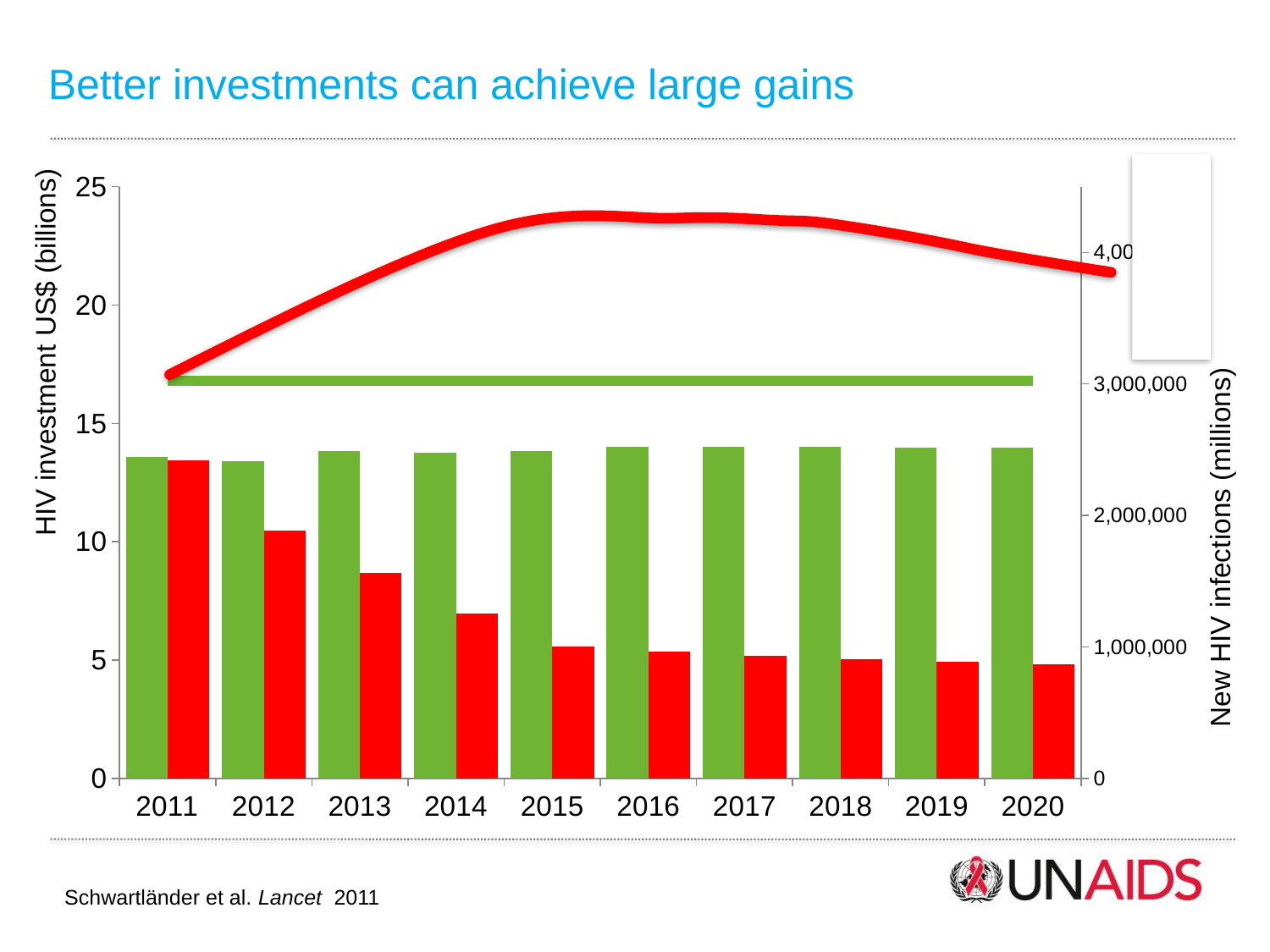
In which year is the red bar highest? 2011 What kind of chart is shown on the slide? A combined bar and line chart In which year is the red bar lowest? 2020 What is the first year shown on the x axis? 2011 Is the red bar for 2011 greater or less than 10 on the left axis? greater Do the red bars rise or fall from 2011 to 2020? Fall Is the green bar for 2016 greater or less than 15 on the left axis? less Is the red bar for 2014 greater or less than 10 on the left axis? less How many years are shown along the x axis? 10 What is the title of the left vertical axis? HIV investment US$ (billions) Which is larger, the red bar for 2011 or the red bar for 2012? 2011